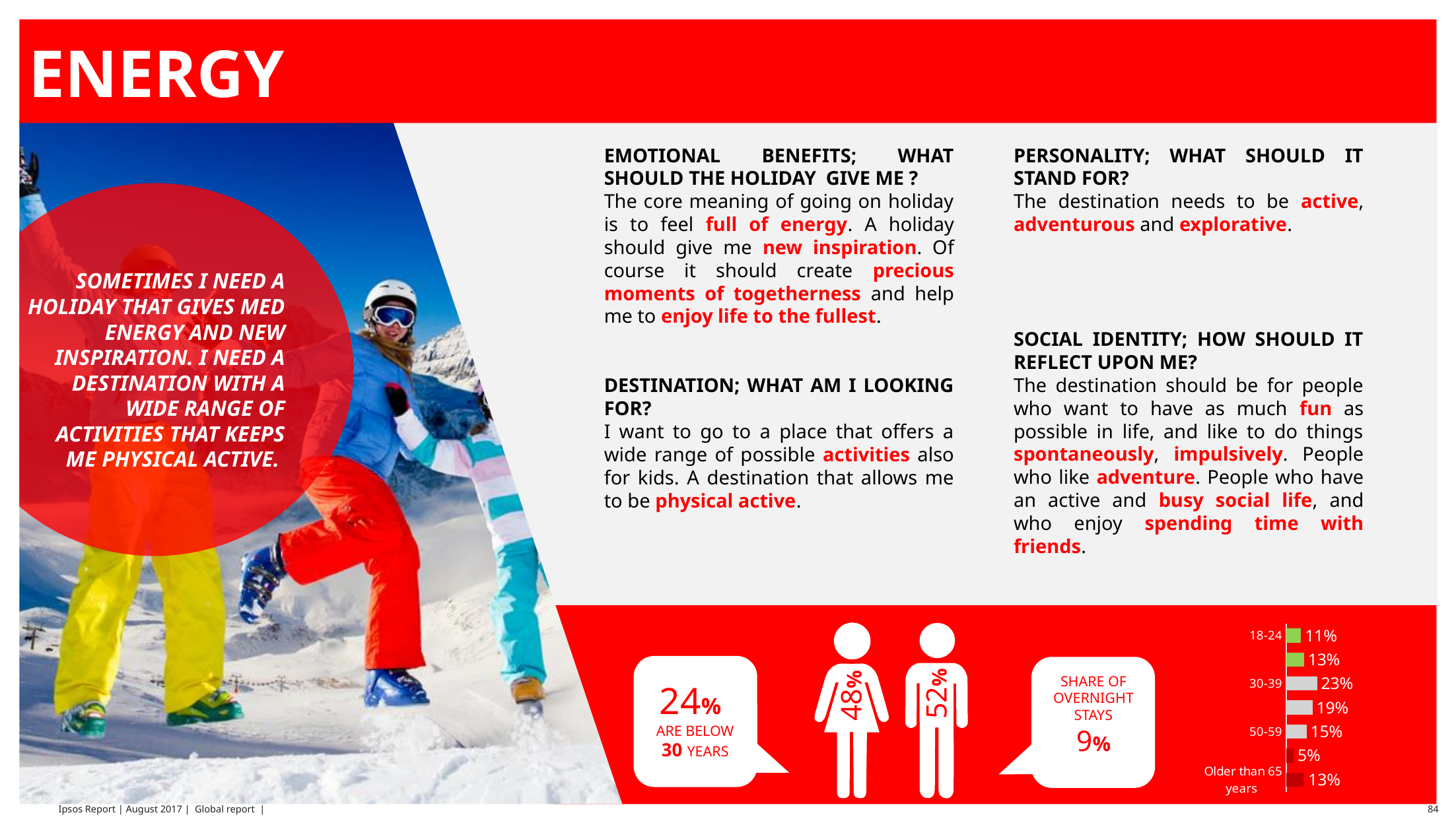
In the bar chart at the bottom right, what is the difference between the values for the 30-39 and 18-24 age groups? 12 percentage points In the bar chart at the bottom right, what is the value for the 18-24 age group? 11% In the bar chart at the bottom right, what is the difference between the values for the 50-59 and 'Older than 65 years' groups? 2 percentage points In the bar chart at the bottom right, what is the smallest value printed on any bar? 5% In the bar chart at the bottom right, what is the value for the 50-59 age group? 15% In the bar chart at the bottom right, which is larger: the value for 30-39 or the value for 50-59? 30-39 In the bar chart at the bottom right, what is the value for the 30-39 age group? 23% In the bar chart at the bottom right, what is the value for the 'Older than 65 years' group? 13% How many bars are shown in the bar chart at the bottom right? 7 In the bar chart at the bottom right, which labelled age group has the highest value? 30-39 In the bar chart at the bottom right, which is larger: the value for 18-24 or the value for 'Older than 65 years'? Older than 65 years What kind of chart is shown at the bottom right of the slide? Bar chart